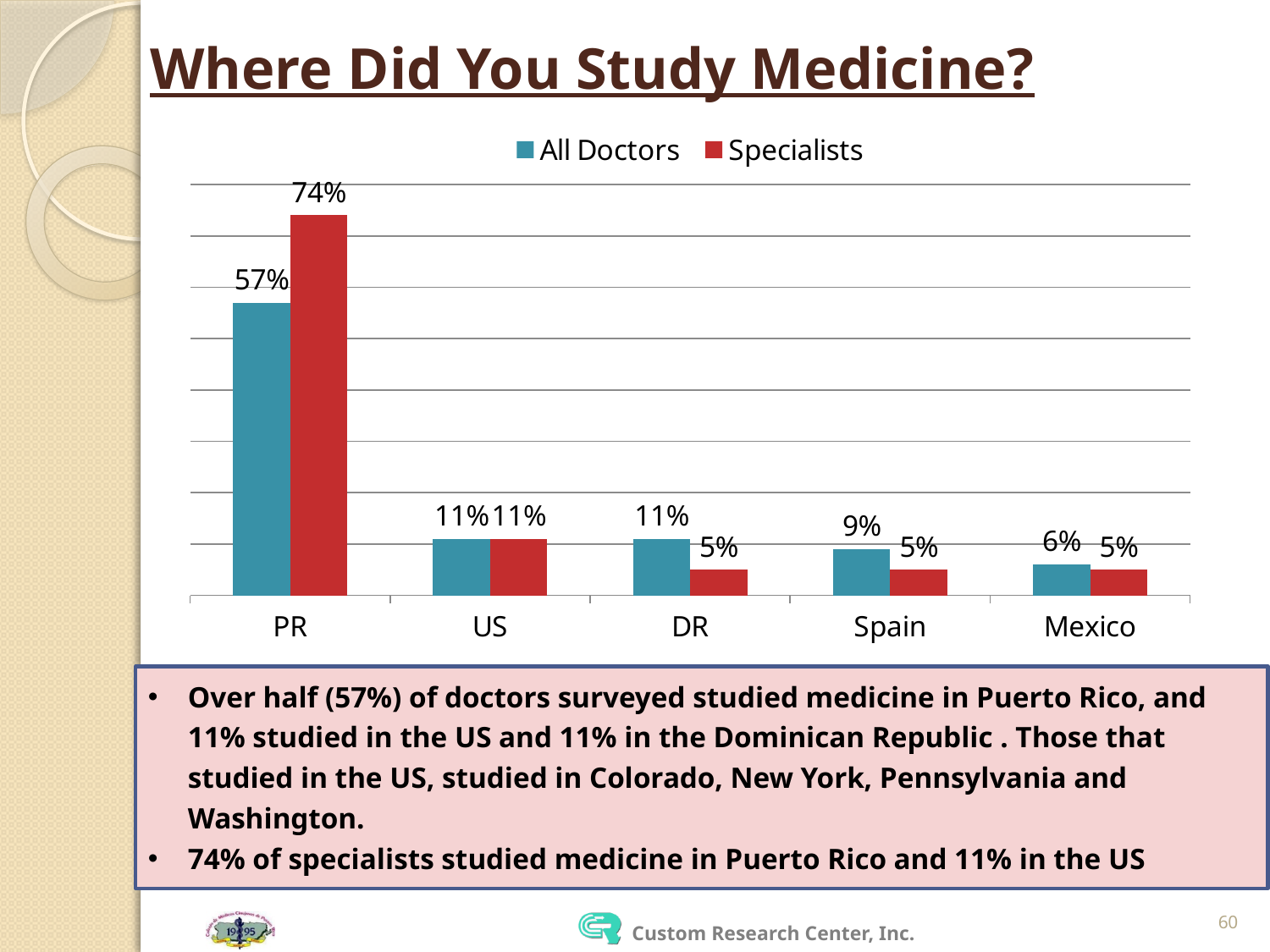
How many countries are shown on the x axis? 5 What percentage of Specialists studied medicine in PR? 74% What is the value for Specialists in DR? 5% What is the difference between Specialists and All Doctors for PR? 17% Which country has the highest value for All Doctors? PR What kind of chart is shown on the slide? Bar chart Which country has the lowest value for Specialists? DR, Spain and Mexico (all 5%) How many series does the legend list? 2 Which is larger for DR: All Doctors or Specialists? All Doctors What is the value for All Doctors in Spain? 9% What is the title of the slide? Where Did You Study Medicine? What percentage of All Doctors studied medicine in PR? 57%